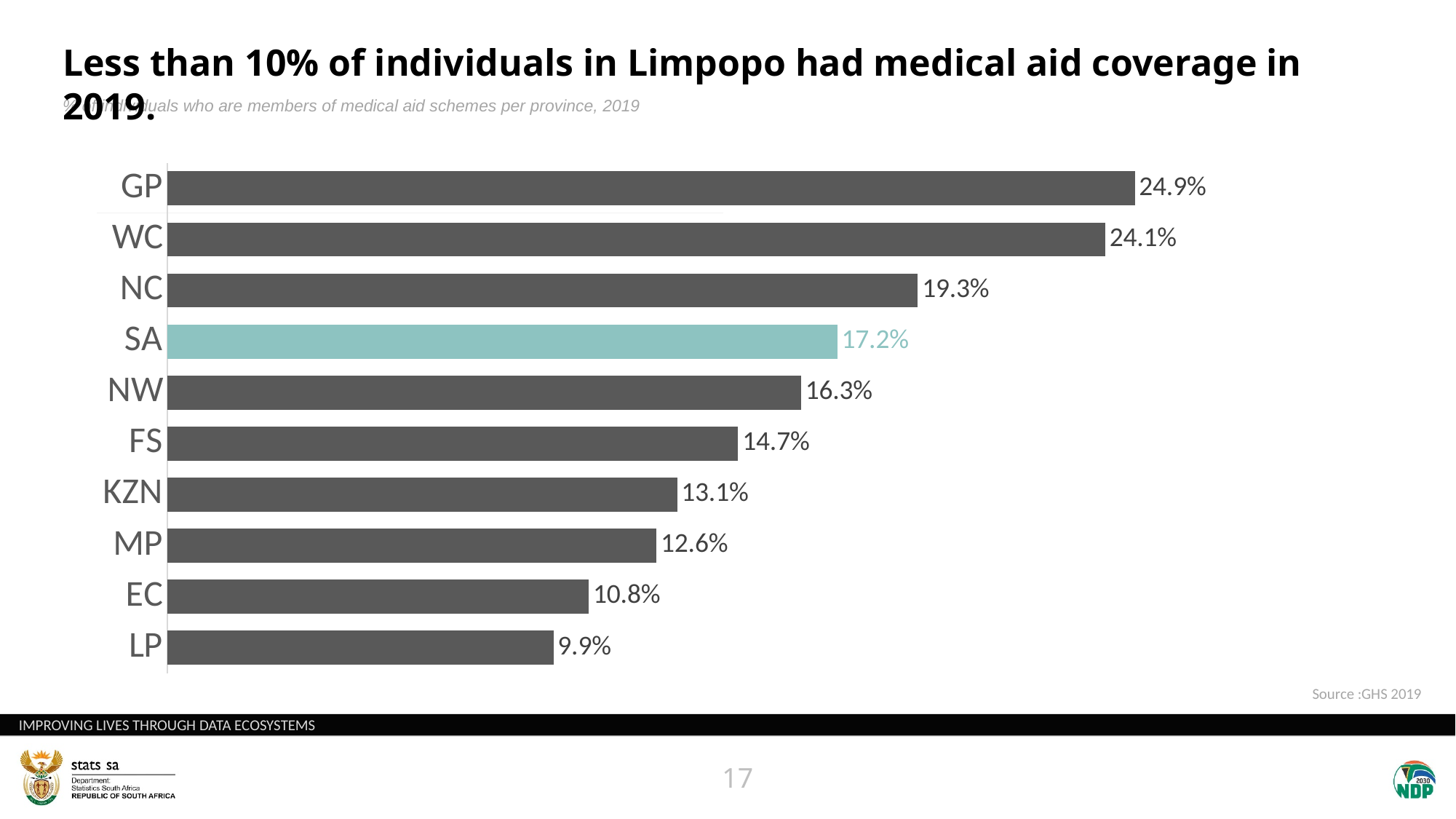
Which bar is shown in a different colour from the others? SA How many categories are shown in the chart? 10 What is the value for LP? 9.9% What is the value for SA? 17.2% What kind of chart is shown on the slide? Bar chart What is the value for KZN? 13.1% Which category has the highest value? GP What is the value for GP? 24.9% Which is larger, the value for FS or the value for MP? FS What is the difference between the values for GP and LP? 15.0% What is the difference between the values for NC and NW? 3.0% Which category has the lowest value? LP